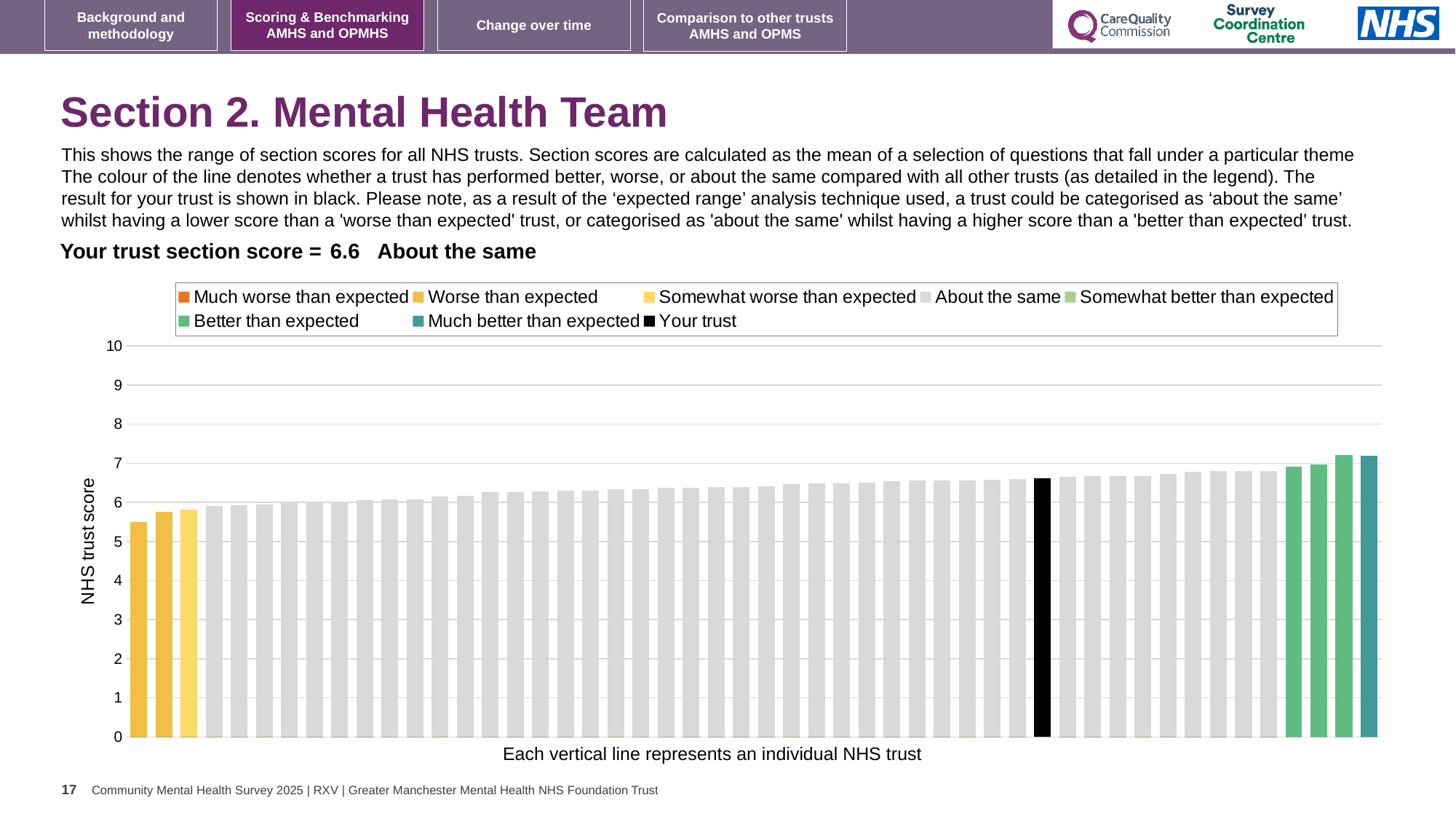
What kind of chart is shown on the slide? bar chart What is the section score for your trust shown on the slide? 6.6 What is the label on the vertical axis of the chart? NHS trust score What colour is used for the 'Your trust' bar in the chart? black Is the value of the highest bar in the chart greater or less than 8? less Do the bar values rise or fall moving from left to right along the x axis? rise Which performance category is your trust placed in for this section? About the same Is the value of the lowest bar in the chart greater or less than 6? less Is the value of the black 'Your trust' bar greater or less than 6? greater How many bars are coloured as 'Worse than expected'? 2 How many entries does the chart legend list? 8 How many bars are coloured as 'Much better than expected'? 1